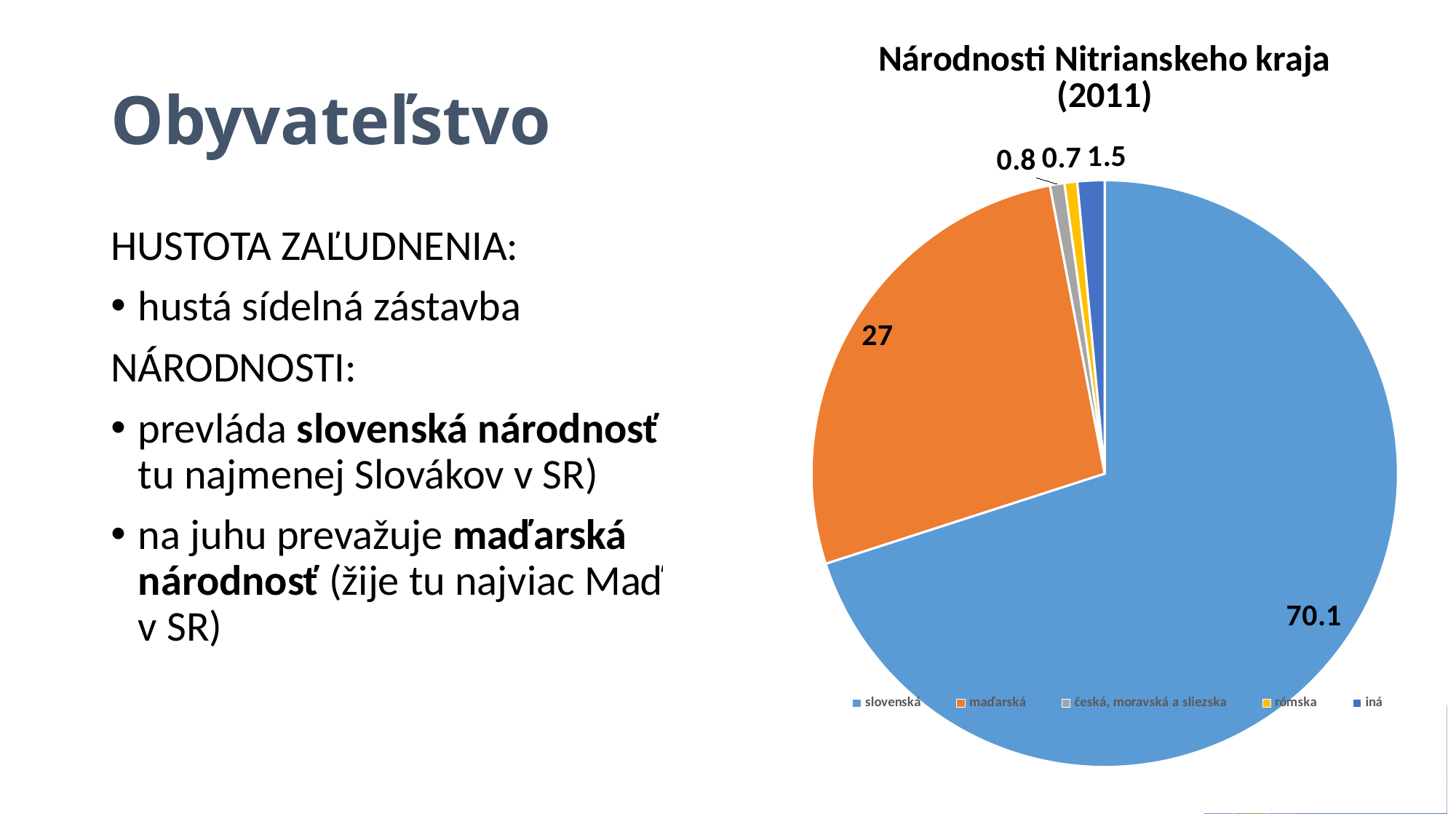
Which is larger, the value for iná or the value for rómska? iná Which nationality has the largest slice in the pie chart? slovenská What is the value for rómska in the pie chart? 0.7 How many categories does the legend of the pie chart list? 5 What is the value for maďarská in the pie chart? 27 What is the value for slovenská in the pie chart? 70.1 What is the title of the chart? Národnosti Nitrianskeho kraja (2011) What is the difference between the values for slovenská and maďarská? 43.1 What is the value for iná in the pie chart? 1.5 What is the value for česká, moravská a sliezska in the pie chart? 0.8 What type of chart is shown on the slide? pie chart Which nationality has the smallest slice in the pie chart? rómska